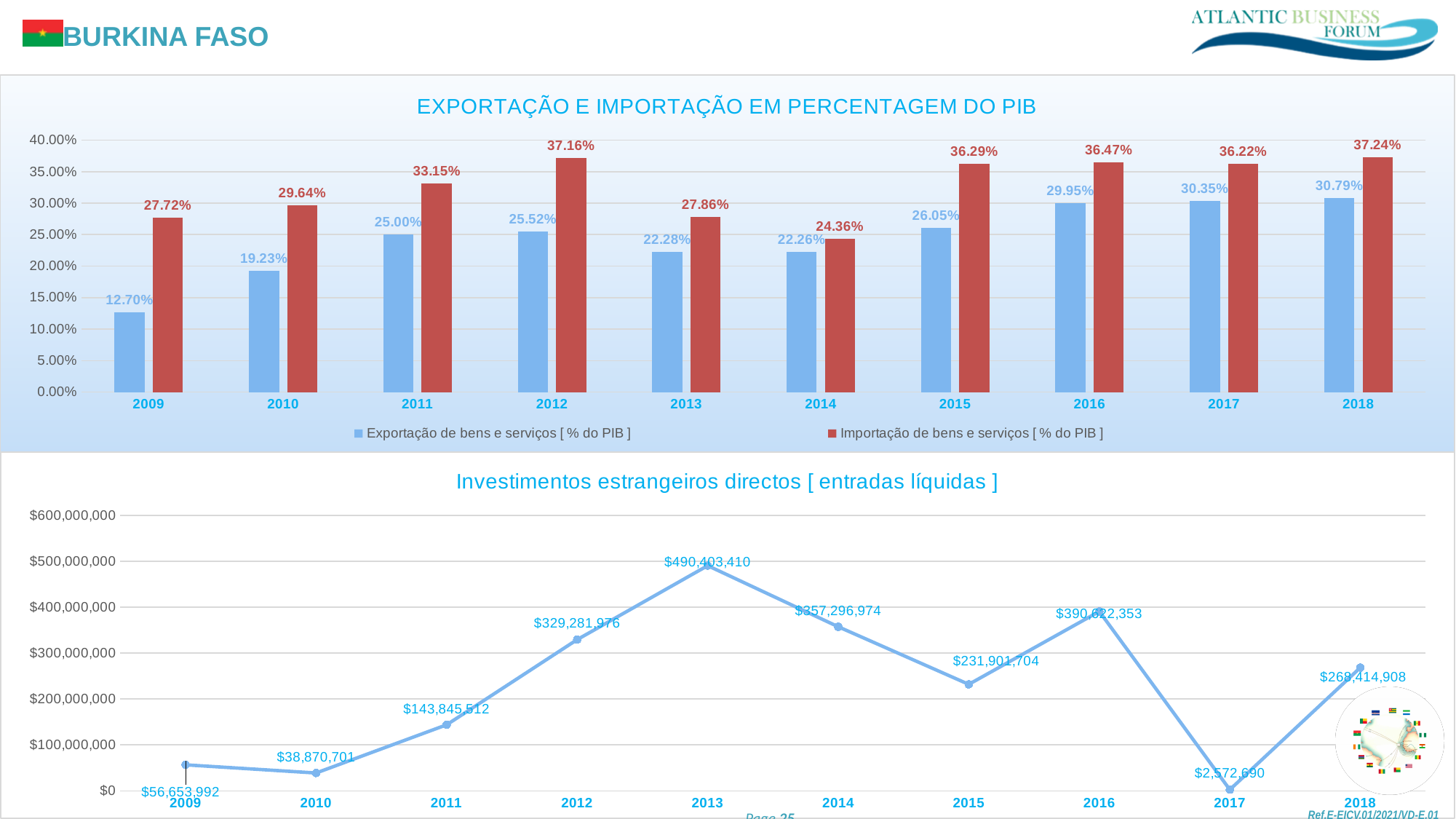
What kind of chart is the top chart on the slide? Bar chart In the chart titled 'EXPORTAÇÃO E IMPORTAÇÃO EM PERCENTAGEM DO PIB', how many series does the legend list? 2 In the chart titled 'EXPORTAÇÃO E IMPORTAÇÃO EM PERCENTAGEM DO PIB', which year has the highest Importação de bens e serviços value? 2018 In the chart titled 'EXPORTAÇÃO E IMPORTAÇÃO EM PERCENTAGEM DO PIB', what is the difference between Importação and Exportação in 2009? 15.02% In the chart titled 'Investimentos estrangeiros directos [ entradas líquidas ]', what is the value for 2013? $490,403,410 In the chart titled 'Investimentos estrangeiros directos [ entradas líquidas ]', which year has the lowest value? 2017 In the chart titled 'EXPORTAÇÃO E IMPORTAÇÃO EM PERCENTAGEM DO PIB', what is the value of Exportação de bens e serviços for 2012? 25.52% In the chart titled 'EXPORTAÇÃO E IMPORTAÇÃO EM PERCENTAGEM DO PIB', how many years are shown on the x axis? 10 In the chart titled 'EXPORTAÇÃO E IMPORTAÇÃO EM PERCENTAGEM DO PIB', which year has the lowest Exportação de bens e serviços value? 2009 In the chart titled 'EXPORTAÇÃO E IMPORTAÇÃO EM PERCENTAGEM DO PIB', what is the value of Importação de bens e serviços for 2015? 36.29% In the chart titled 'Investimentos estrangeiros directos [ entradas líquidas ]', is the value for 2016 larger or smaller than the value for 2014? Larger What kind of chart is the bottom chart on the slide? Line chart